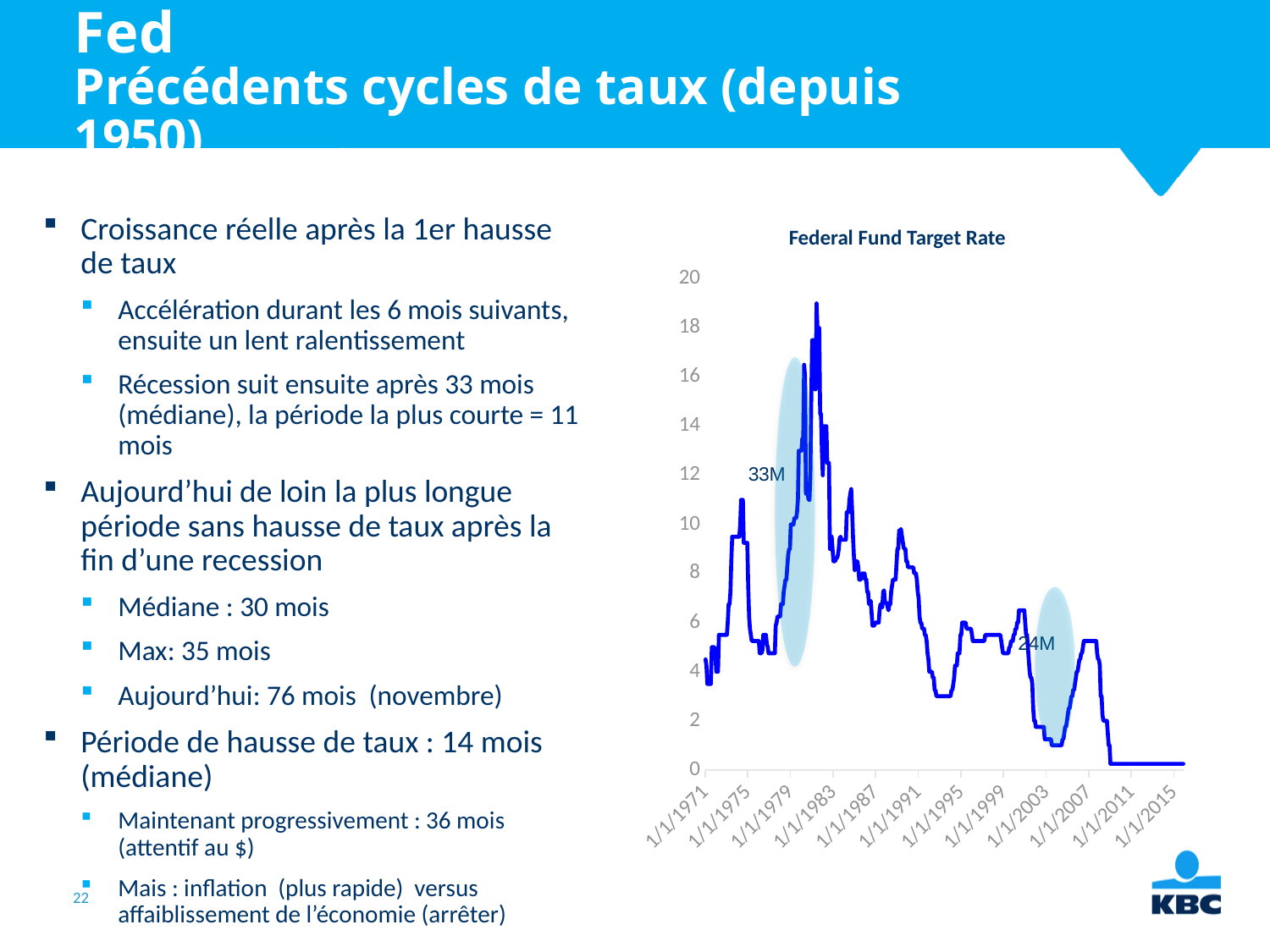
How many date labels are shown on the x axis of the chart? 12 What is the title of the chart? Federal Fund Target Rate Is the value of the Federal Fund Target Rate at 1/1/2003 greater or less than 4? less Is the value of the Federal Fund Target Rate at 1/1/2007 greater or less than 4? greater What kind of chart is shown on the slide? line chart Is the value of the Federal Fund Target Rate at 1/1/2015 greater or less than 2? less What labels are written inside the two shaded ellipses on the chart? 33M and 24M Does the Federal Fund Target Rate rise or fall between 1/1/2003 and 1/1/2007? rise Does the Federal Fund Target Rate rise or fall between 1/1/2007 and 1/1/2011? fall Which is larger, the Federal Fund Target Rate at 1/1/1983 or at 1/1/2015? 1/1/1983